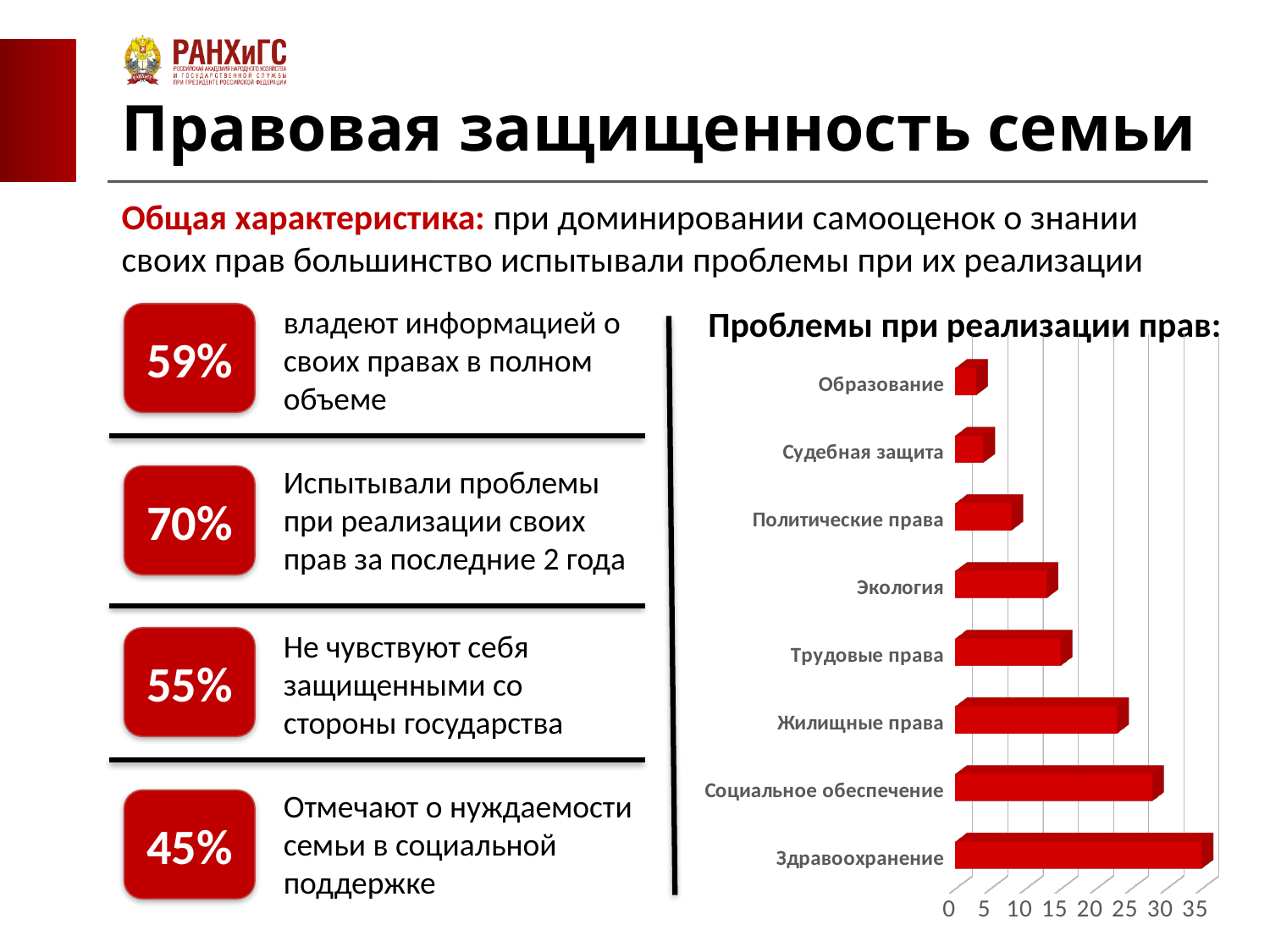
Is the value for Социальное обеспечение greater or less than 25? greater Is the value for Здравоохранение greater or less than 30? greater How many categories does the chart "Проблемы при реализации прав" show? 8 Is the value for Экология greater or less than 10? greater Which category has the shortest bar in the chart "Проблемы при реализации прав"? Образование Which category has the longest bar in the chart "Проблемы при реализации прав"? Здравоохранение Which is larger, the value for Жилищные права or the value for Трудовые права? Жилищные права Going from the top category to the bottom category, do the bars get longer or shorter? longer What kind of chart is shown under the heading "Проблемы при реализации прав"? bar chart